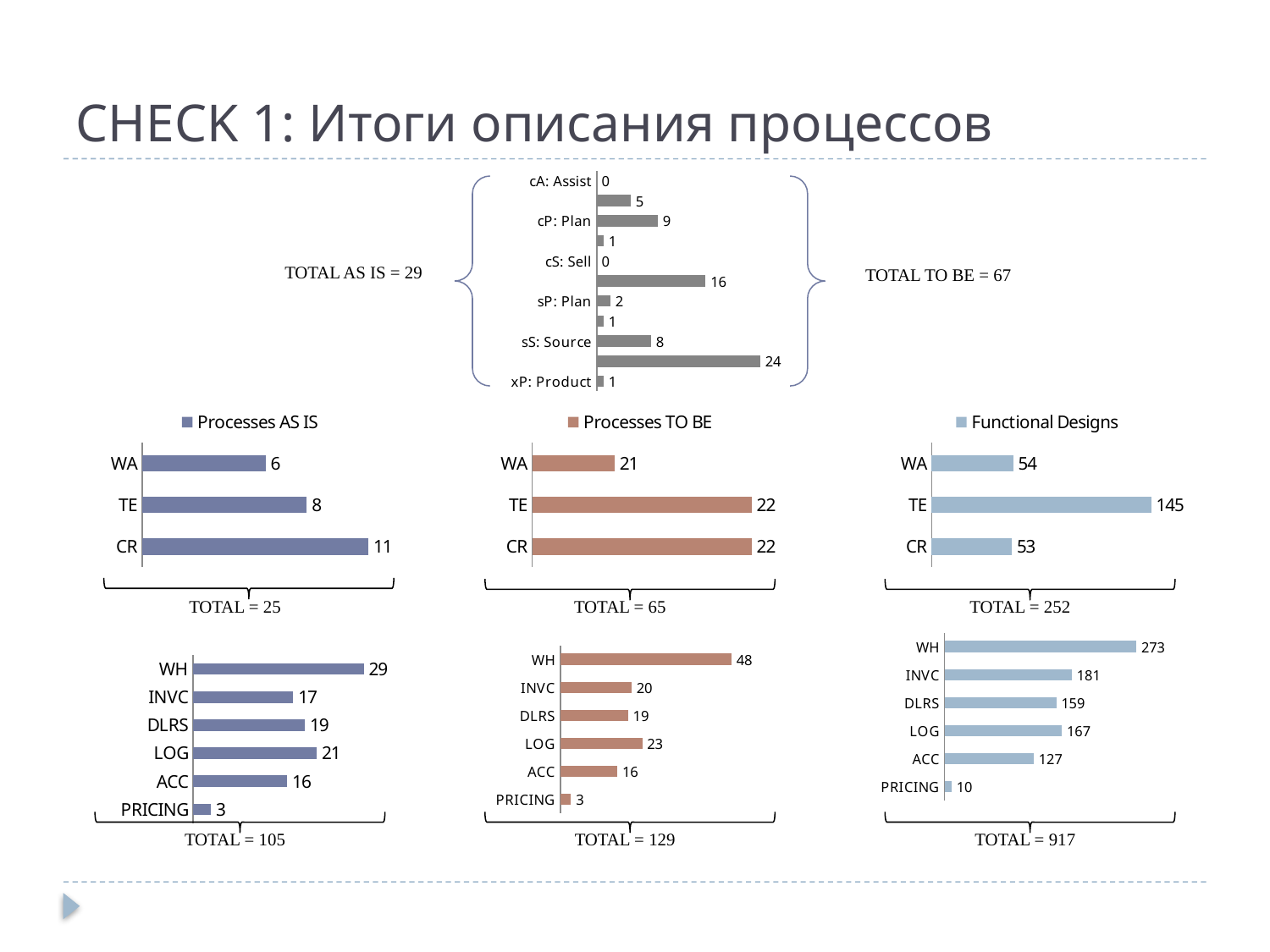
In the bottom-right chart (WH to PRICING), which category has the lowest value? PRICING In the bottom-left chart (WH to PRICING), what is the value for LOG? 21 In the bottom-middle chart (WH to PRICING), what is the value for ACC? 16 In the "Processes AS IS" chart, what is the value for CR? 11 In the "Functional Designs" chart, what is the difference between the values for TE and WA? 91 What type of chart is the "Processes TO BE" chart? Bar chart In the "Processes TO BE" chart, what is the value for WA? 21 How many categories are shown in the bottom-middle chart (WH to PRICING)? 6 In the "Processes AS IS" chart, which category has the lowest value? WA In the bottom-right chart (WH to PRICING), which is larger, the value for INVC or the value for LOG? INVC In the bottom-left chart (WH to PRICING), which category has the highest value? WH In the "Functional Designs" chart, which category has the highest value? TE